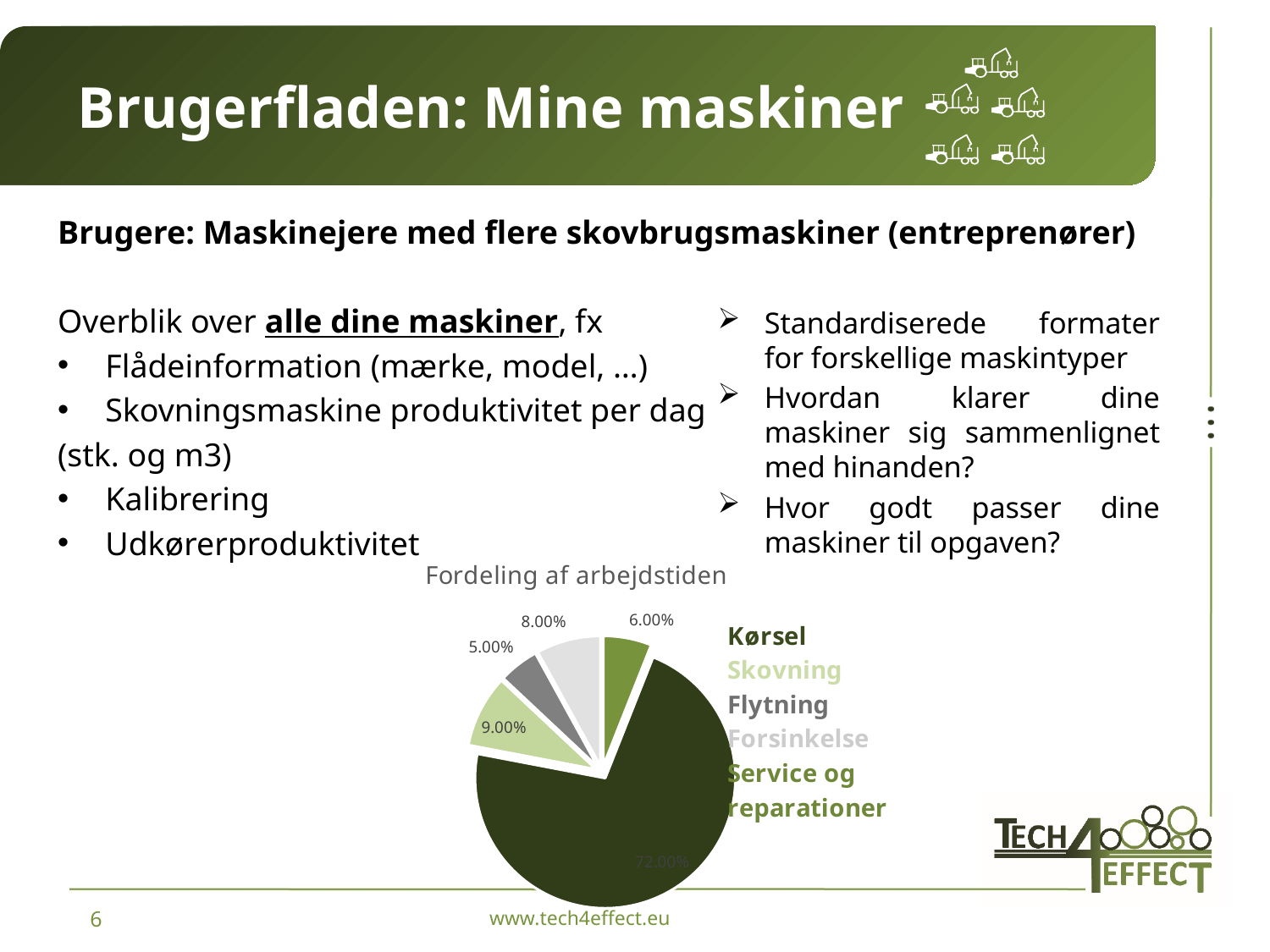
What is the difference between the 8.00% slice and the 5.00% slice? 3.00% How many entries does the legend of the pie chart list? 5 Which is larger in the pie chart, the 6.00% slice or the 9.00% slice? the 9.00% slice What kind of chart is shown on the slide? pie chart What is the title of the pie chart? Fordeling af arbejdstiden What is the value of the largest slice in the pie chart? 72.00% What is the value of the smallest slice in the pie chart? 5.00% What is the difference between the largest slice (72.00%) and the 9.00% slice? 63.00% What is the combined share of the four smallest slices in the pie chart? 28.00% Which legend entry is listed last in the pie chart's legend? Service og reparationer How many slices does the pie chart have? 5